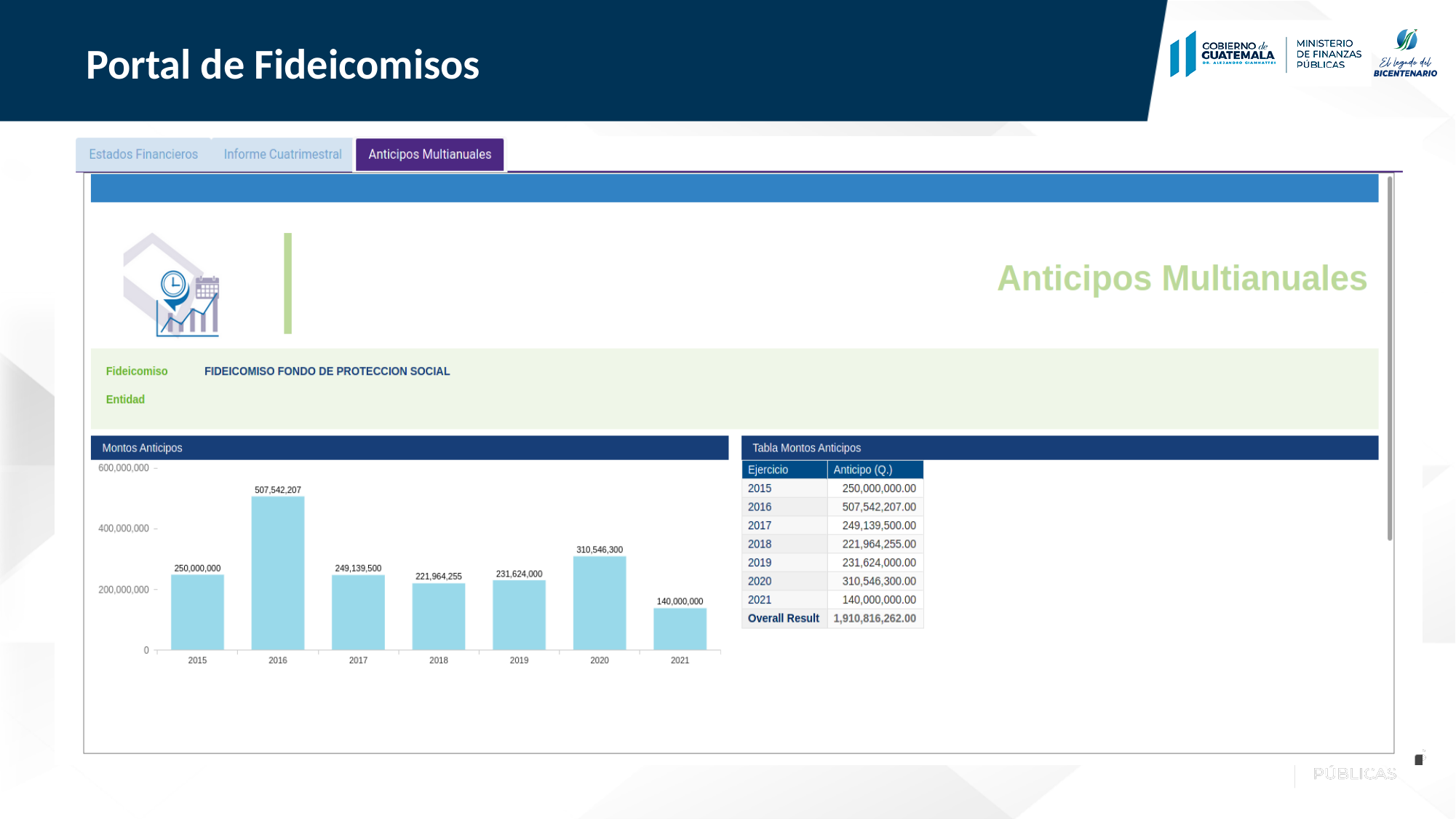
What is the title of the bar chart on the slide? Montos Anticipos What type of chart is the 'Montos Anticipos' chart? bar chart In the 'Montos Anticipos' chart, which year has the lowest value? 2021 In the 'Montos Anticipos' chart, is the value for 2016 greater or less than 400,000,000? greater In the 'Montos Anticipos' chart, which year has the highest value? 2016 In the 'Montos Anticipos' chart, what is the difference between the values for 2016 and 2015? 257,542,207 In the 'Montos Anticipos' chart, what is the value for 2016? 507,542,207 How many years are shown on the x axis of the 'Montos Anticipos' chart? 7 In the 'Montos Anticipos' chart, what is the value for 2020? 310,546,300 In the 'Montos Anticipos' chart, what is the value for 2018? 221,964,255 In the 'Montos Anticipos' chart, what is the difference between the values for 2020 and 2021? 170,546,300 In the 'Montos Anticipos' chart, which is larger, the value for 2017 or the value for 2019? 2017